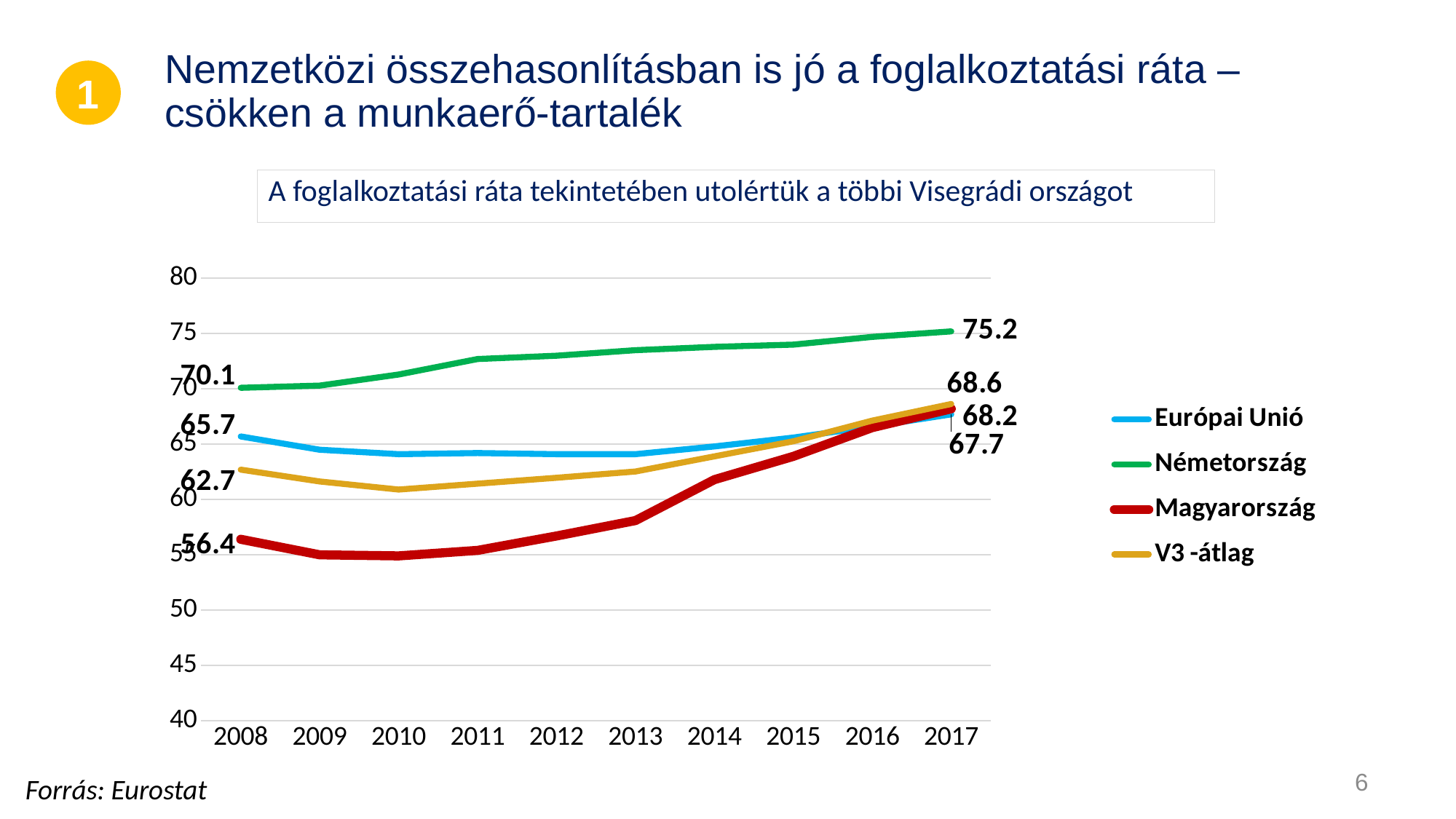
What type of chart is shown on the slide? line chart How many years are shown on the x axis? 10 Does the value for Magyarország rise or fall between 2010 and 2017? rise How many series does the legend list? 4 What is the value for Németország in 2008? 70.1 What is the value for Németország in 2017? 75.2 What is the value for Magyarország in 2008? 56.4 By how much did the value for Németország increase from 2008 to 2017? 5.1 Which series has the highest value in 2008? Németország What is the value for Magyarország in 2017? 68.2 Which series has the lowest value in 2008? Magyarország Is the value for Magyarország in 2010 greater or less than 60? less